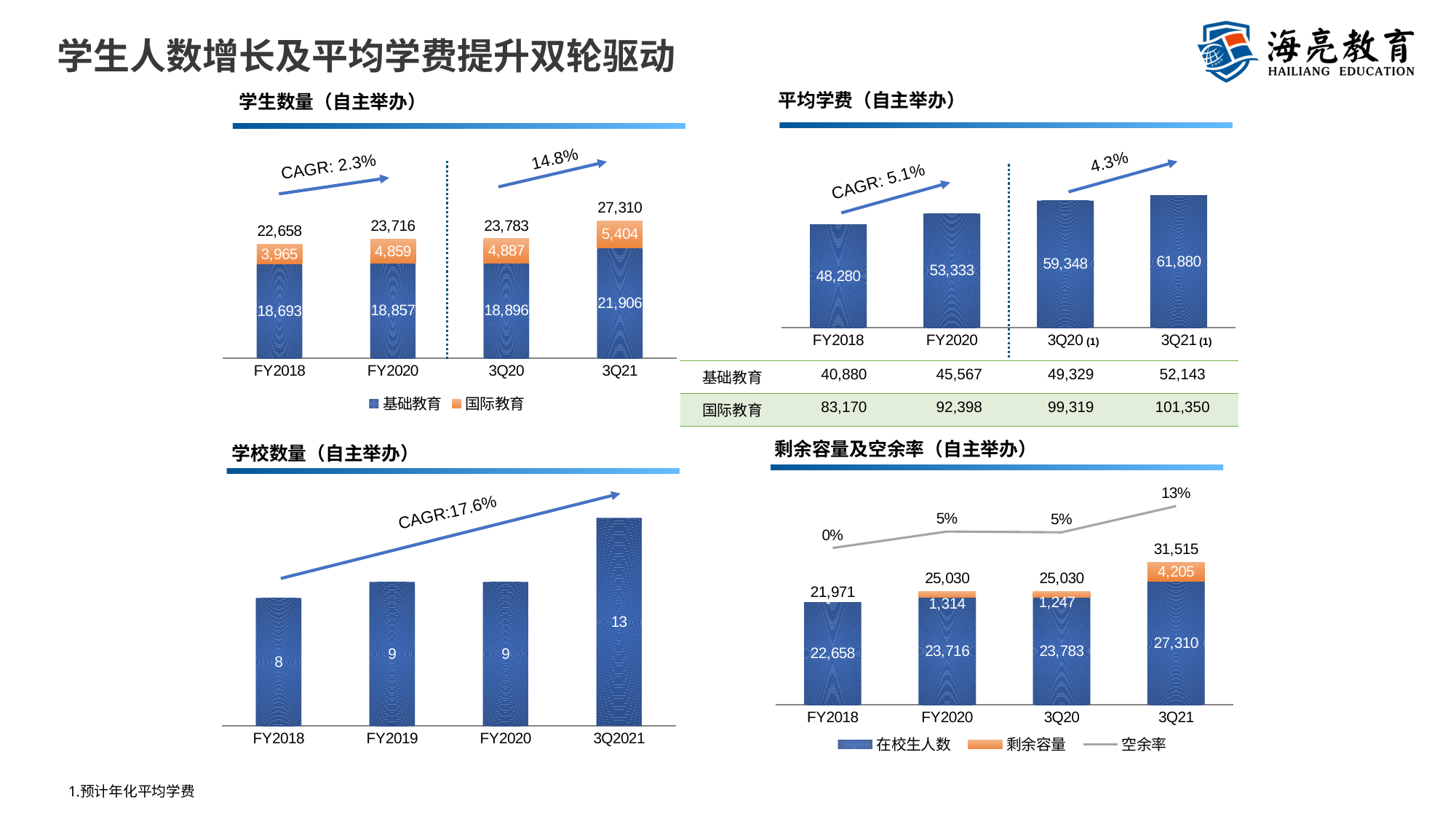
In the 剩余容量及空余率（自主举办） chart, what is the 空余率 value for 3Q21? 13% In the 学校数量（自主举办） chart, what is the value for 3Q2021? 13 In the 学生数量（自主举办） chart, what is the difference between the 基础教育 values for 3Q21 and 3Q20? 3,010 What kind of chart is the 学校数量（自主举办） chart? Bar chart In the 剩余容量及空余率（自主举办） chart, what is the 剩余容量 value for FY2020? 1,314 In the 学生数量（自主举办） chart, what is the 国际教育 value for 3Q21? 5,404 In the 学校数量（自主举办） chart, how many categories are shown on the x axis? 4 In the 学生数量（自主举办） chart, how many series does the legend list? 2 In the 学生数量（自主举办） chart, what is the total of the stacked bar for FY2020? 23,716 In the 平均学费（自主举办） chart, which period has the highest value? 3Q21 In the 平均学费（自主举办） chart, what is the value for FY2020? 53,333 In the 平均学费（自主举办） chart, what is the 国际教育 value shown in the table for 3Q20? 99,319